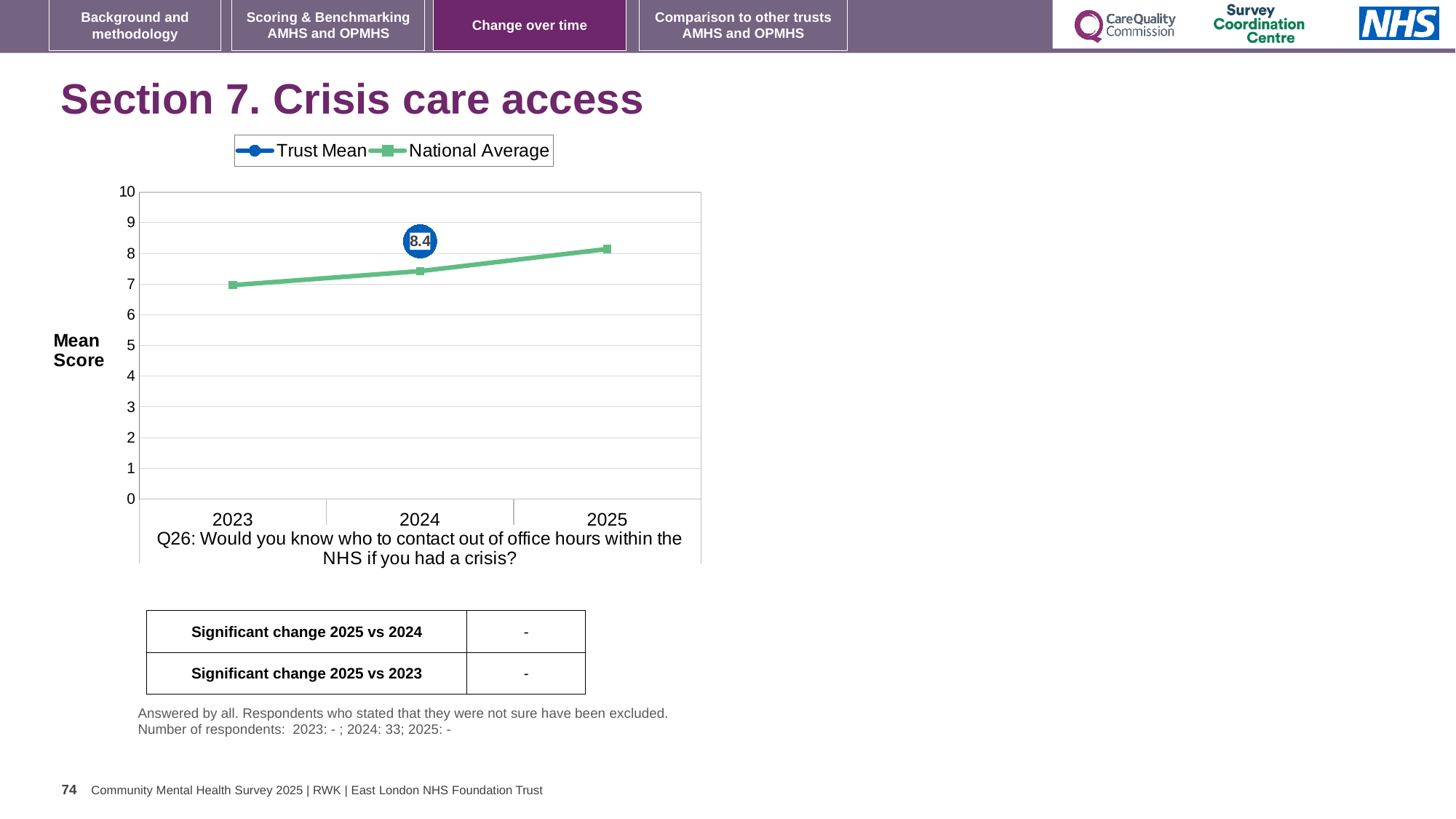
What is the Trust Mean score for 2024? 8.4 Is the National Average for 2025 greater or less than 7? greater What kind of chart is shown on the slide? line chart Which survey question does the chart relate to? Q26: Would you know who to contact out of office hours within the NHS if you had a crisis? In 2024, which is larger: the Trust Mean or the National Average? Trust Mean Is the National Average for 2023 greater or less than 8? less In which year is the National Average lowest? 2023 What is the label on the y axis of the chart? Mean Score How many years are shown on the x axis? 3 How many series does the legend list? 2 In which year is the National Average highest? 2025 Does the National Average rise or fall from 2023 to 2025? rise